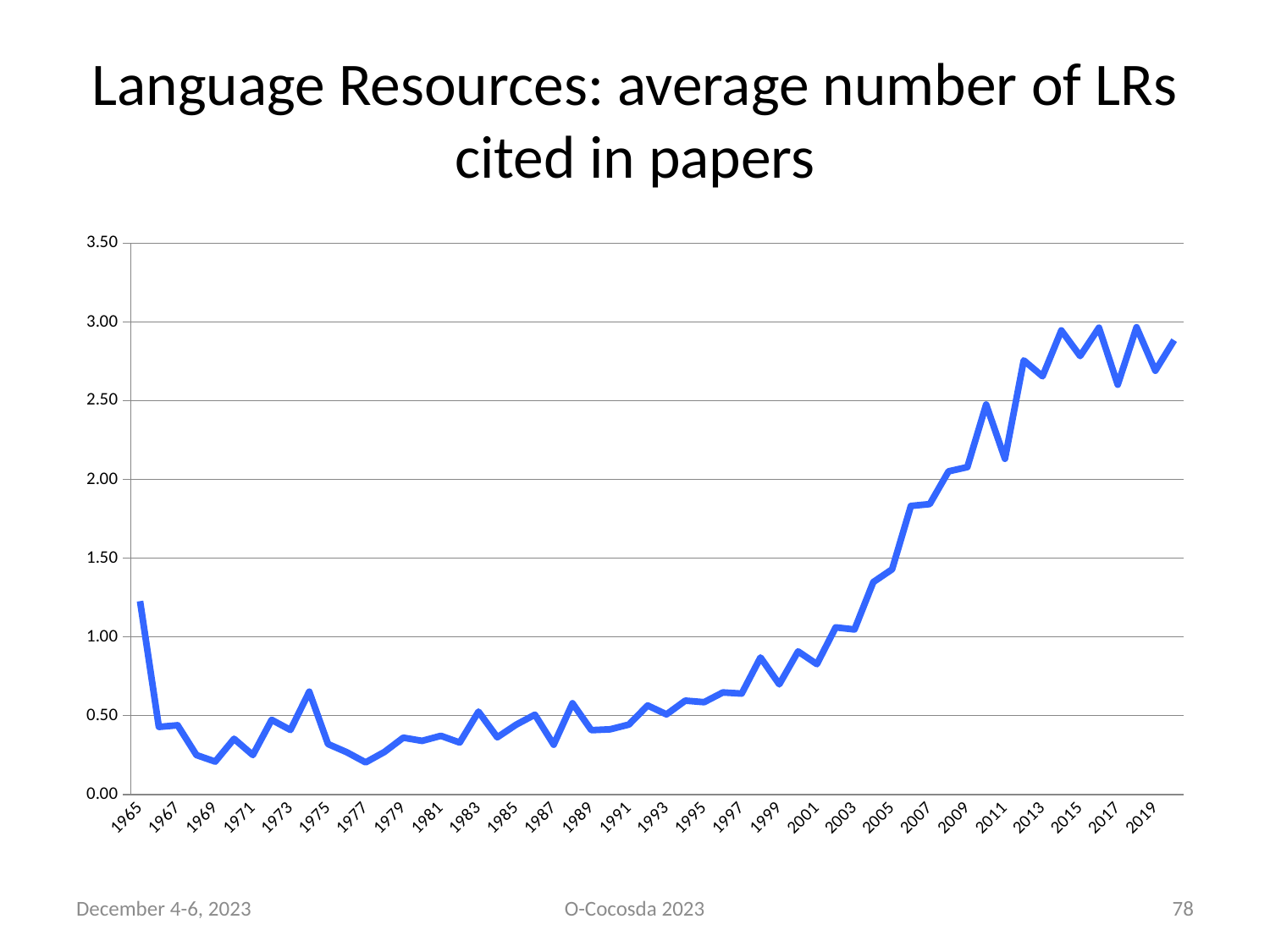
Is the value for 1977 greater or less than 0.50? less Is the value for 1965 greater or less than 1.00? greater Do the values generally rise or fall from 2001 to 2009? rise Which year has the larger value, 1995 or 2019? 2019 What kind of chart is shown on the slide? line chart Is the value for 1999 greater or less than 1.00? less What is the highest value shown on the y axis? 3.50 Which year has the larger value, 1965 or 1967? 1965 What is the title of the chart? Language Resources: average number of LRs cited in papers